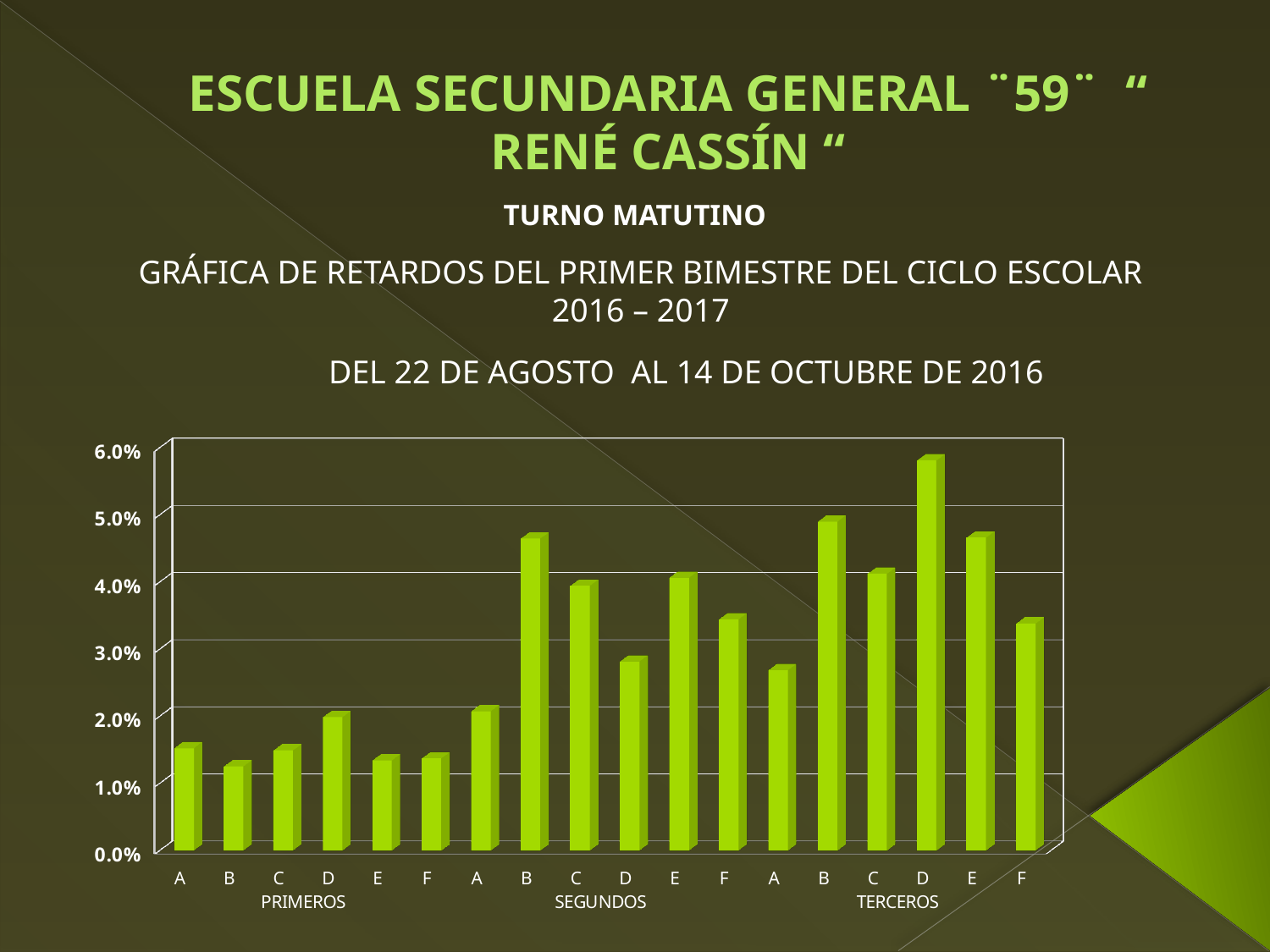
Which group and section has the highest percentage of retardos? TERCEROS D What is the highest value shown on the y axis? 6.0% What kind of chart is shown on the slide? bar chart Which is larger, the value for SEGUNDOS B or the value for PRIMEROS B? SEGUNDOS B Which is larger, the value for TERCEROS B or the value for SEGUNDOS C? TERCEROS B Is the value for TERCEROS A greater or less than 3.0%? less Is the value for SEGUNDOS B greater or less than 4.0%? greater Is the value for PRIMEROS A greater or less than 2.0%? less How many bars are plotted in the chart? 18 What are the three grade groups labelled along the x axis? PRIMEROS, SEGUNDOS, TERCEROS